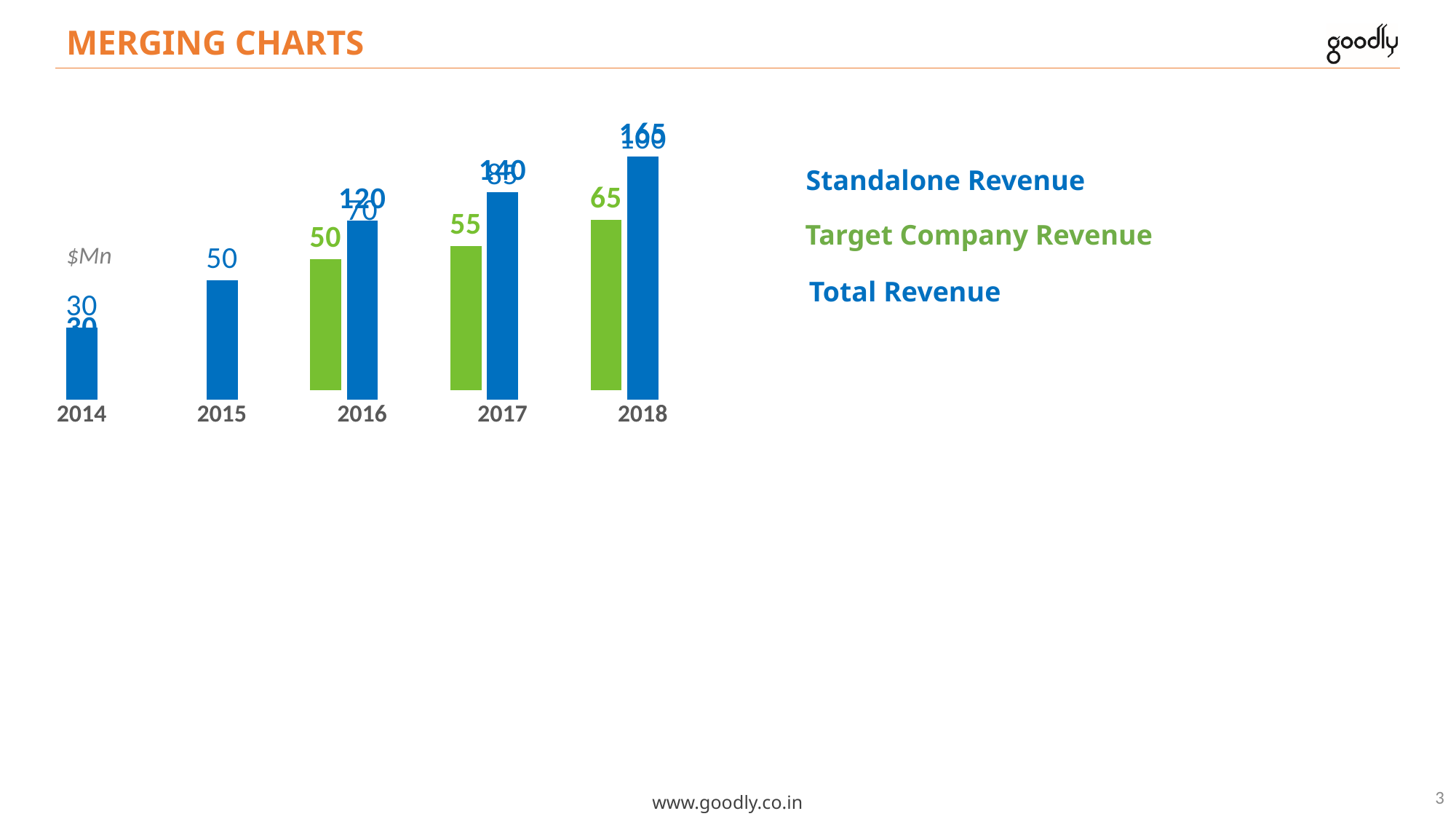
What is the Target Company Revenue value for 2018? 65 What is the difference between Target Company Revenue in 2018 and 2016? 15 How many years are shown on the x axis? 5 Do the Standalone Revenue bars rise or fall from 2014 to 2018? rise What kind of chart is shown on the slide? bar chart Which year has the lowest Standalone Revenue? 2014 Which year has the highest Target Company Revenue? 2018 What unit is shown next to the chart? $Mn What is the Target Company Revenue value for 2017? 55 What is the Standalone Revenue value for 2015? 50 What is the Target Company Revenue value for 2016? 50 How many series does the legend list? 3